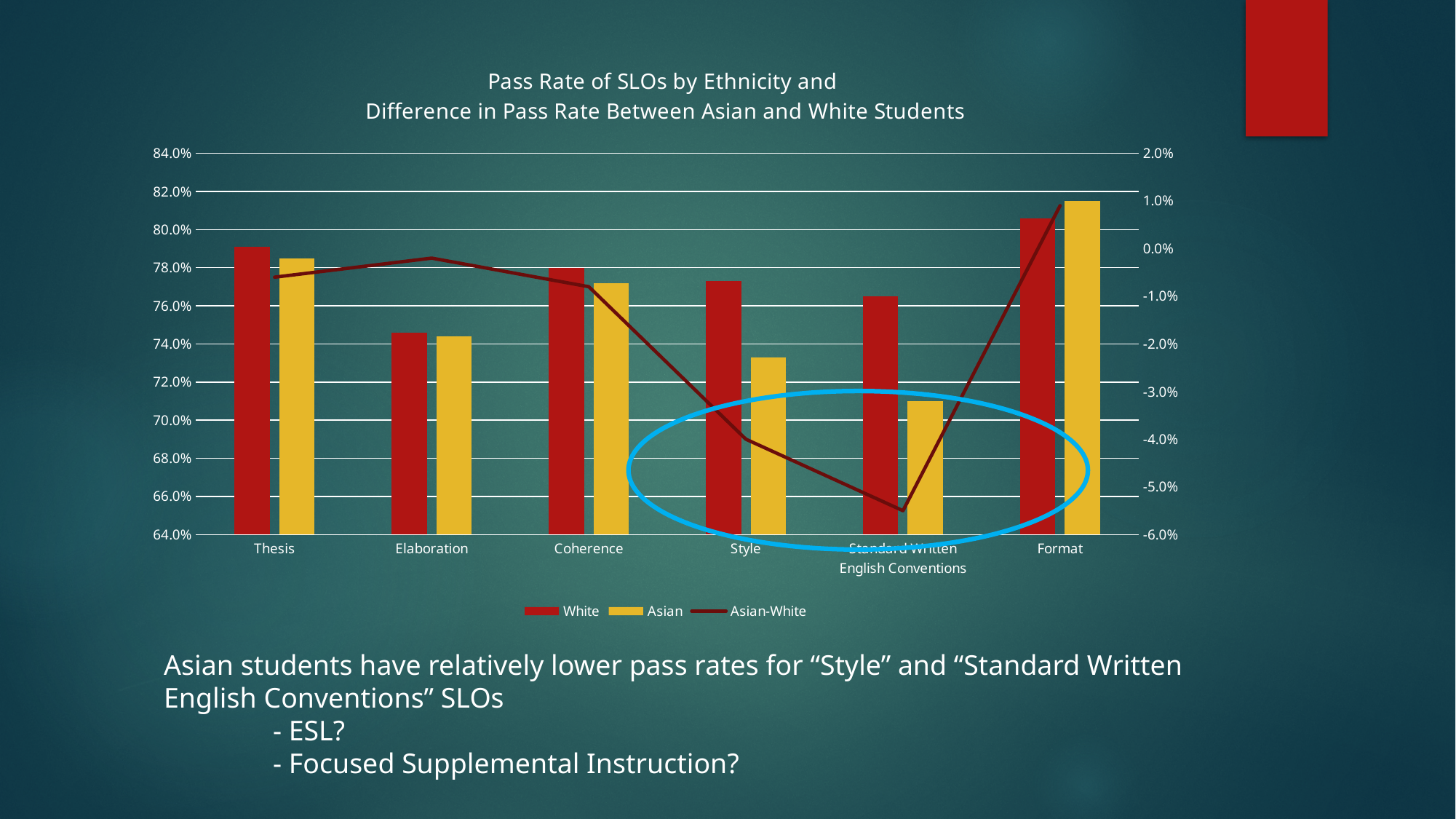
For Thesis, which group has the higher pass rate, White or Asian? White How many SLO categories are shown on the x axis? 6 Which SLO has the highest pass rate for White students? Format Is the White pass rate for Format greater or less than 80.0%? greater How many series does the legend list? 3 At which SLO does the Asian-White difference line reach its lowest point? Standard Written English Conventions Is the Asian pass rate for Style greater or less than 74.0%? less Which SLO has the lowest pass rate for Asian students? Standard Written English Conventions Which SLO has the highest pass rate for Asian students? Format Which SLO has the lowest pass rate for White students? Elaboration Does the Asian-White difference line rise or fall from Coherence to Standard Written English Conventions? fall What kind of chart is shown on the slide? A bar chart combined with a line